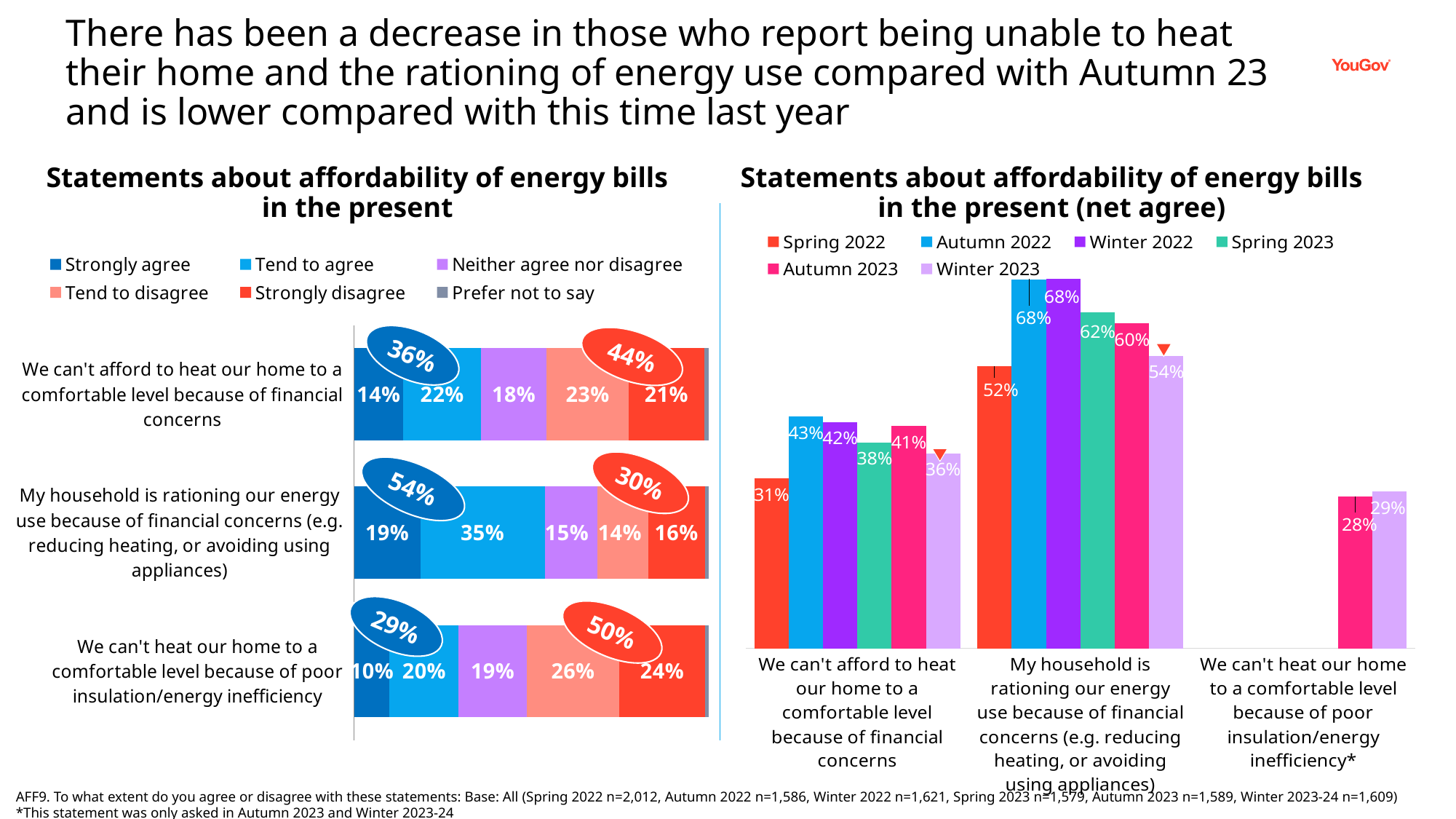
What kind of chart is the left chart (Statements about affordability of energy bills in the present)? Stacked bar chart In the left chart (Statements about affordability of energy bills in the present), what percentage strongly agree that their household is rationing energy use because of financial concerns? 19% In the right chart (net agree), from Winter 2022 to Winter 2023, do the values for the statement about rationing energy use rise or fall? Fall How many series does the legend of the right chart (net agree) list? 6 In the right chart (net agree), which wave has the highest value for 'We can't afford to heat our home to a comfortable level because of financial concerns'? Autumn 2022 In the left chart, what percentage strongly disagree with the statement about not being able to heat the home because of poor insulation/energy inefficiency? 24% In the left chart, what percentage neither agree nor disagree that they can't afford to heat their home to a comfortable level because of financial concerns? 18% In the right chart (net agree), what is the Spring 2022 value for 'We can't afford to heat our home to a comfortable level because of financial concerns'? 31% In the right chart (net agree), what is the difference between the Autumn 2022 and Winter 2023 values for the statement about rationing energy use? 14 percentage points In the right chart (net agree), what is the Winter 2023 value for the statement about poor insulation/energy inefficiency? 29% In the right chart (net agree), what is the Winter 2023 value for the statement about rationing energy use? 54% How many statements (categories) are shown on the x axis of the right chart (net agree)? 3